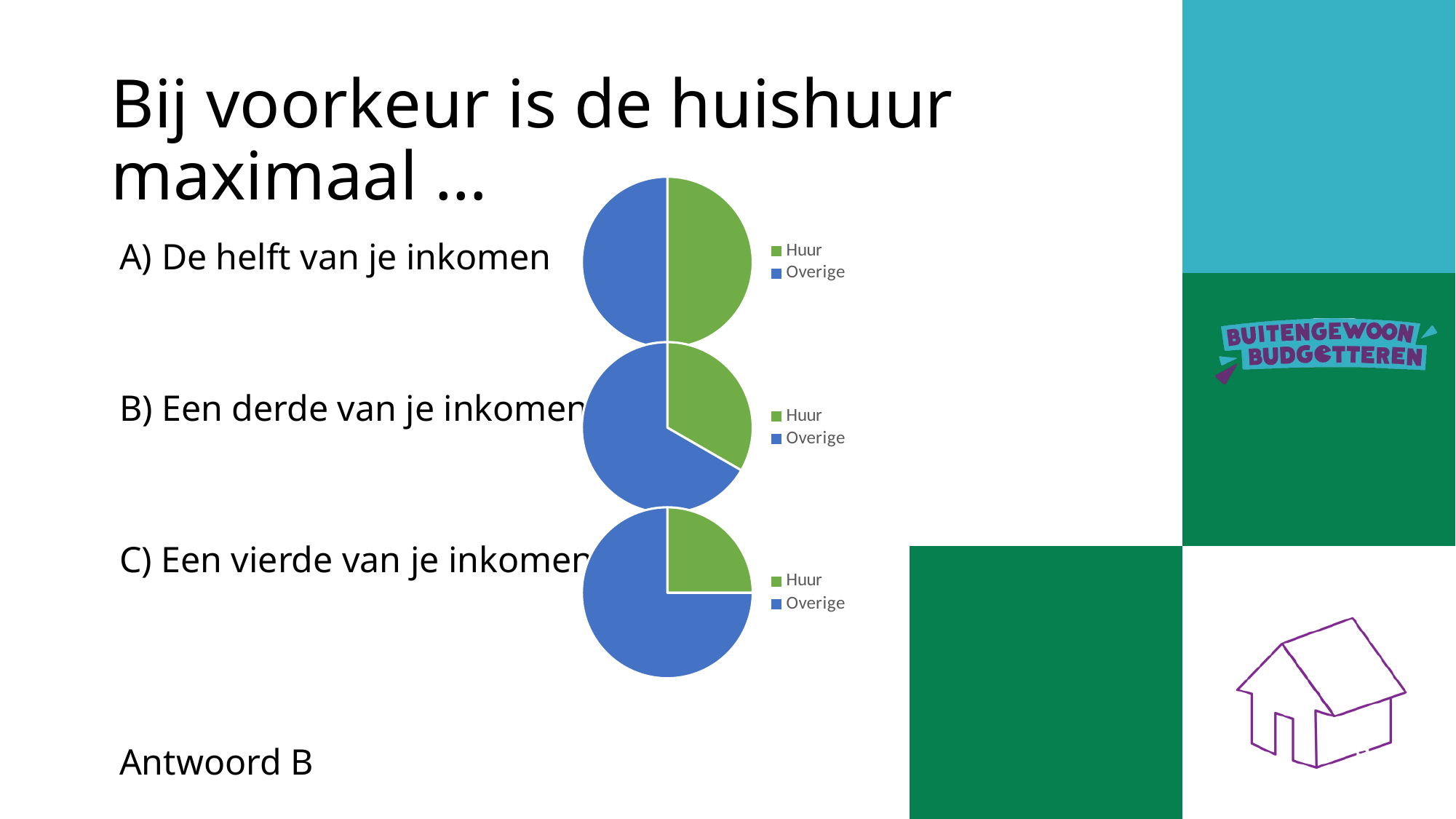
In the bottom pie chart, which slice is larger, Huur or Overige? Overige In the middle pie chart, which category has the largest slice? Overige How many pie charts are shown on the slide? 3 What kind of chart is the top chart on the slide? pie chart How many entries does the legend of the bottom pie chart list? 2 In the bottom pie chart, which category has the smallest slice? Huur In the middle pie chart, which slice is larger, Huur or Overige? Overige In the bottom pie chart, what colour is the Huur slice? green How many slices does the middle pie chart have? 2 What are the two legend entries of the top pie chart? Huur, Overige